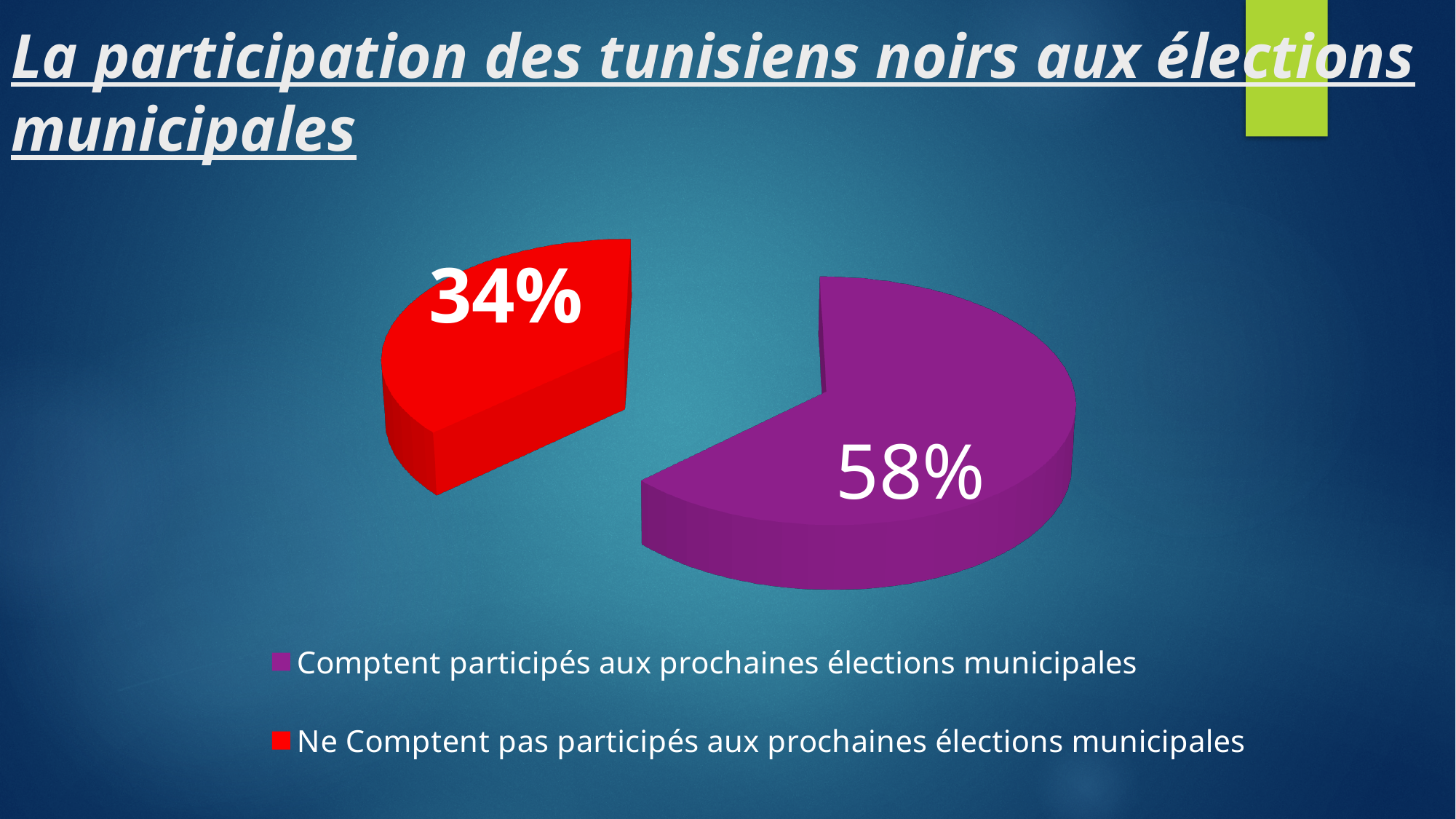
What colour is the slice for 'Ne Comptent pas participés aux prochaines élections municipales'? Red What kind of chart is shown on the slide? Pie chart What percentage of the pie is labelled for 'Ne Comptent pas participés aux prochaines élections municipales'? 34% What is the difference in percentage points between the 'Comptent participés' slice and the 'Ne Comptent pas participés' slice? 24 How many entries does the legend list? 2 What percentage of the pie is labelled for 'Comptent participés aux prochaines élections municipales'? 58% Which category has the largest slice of the pie? Comptent participés aux prochaines élections municipales Which category has the smallest slice of the pie? Ne Comptent pas participés aux prochaines élections municipales Which is larger: the slice for 'Comptent participés aux prochaines élections municipales' or the slice for 'Ne Comptent pas participés aux prochaines élections municipales'? Comptent participés aux prochaines élections municipales How many slices does the pie chart have? 2 What is the title of the slide containing the chart? La participation des tunisiens noirs aux élections municipales